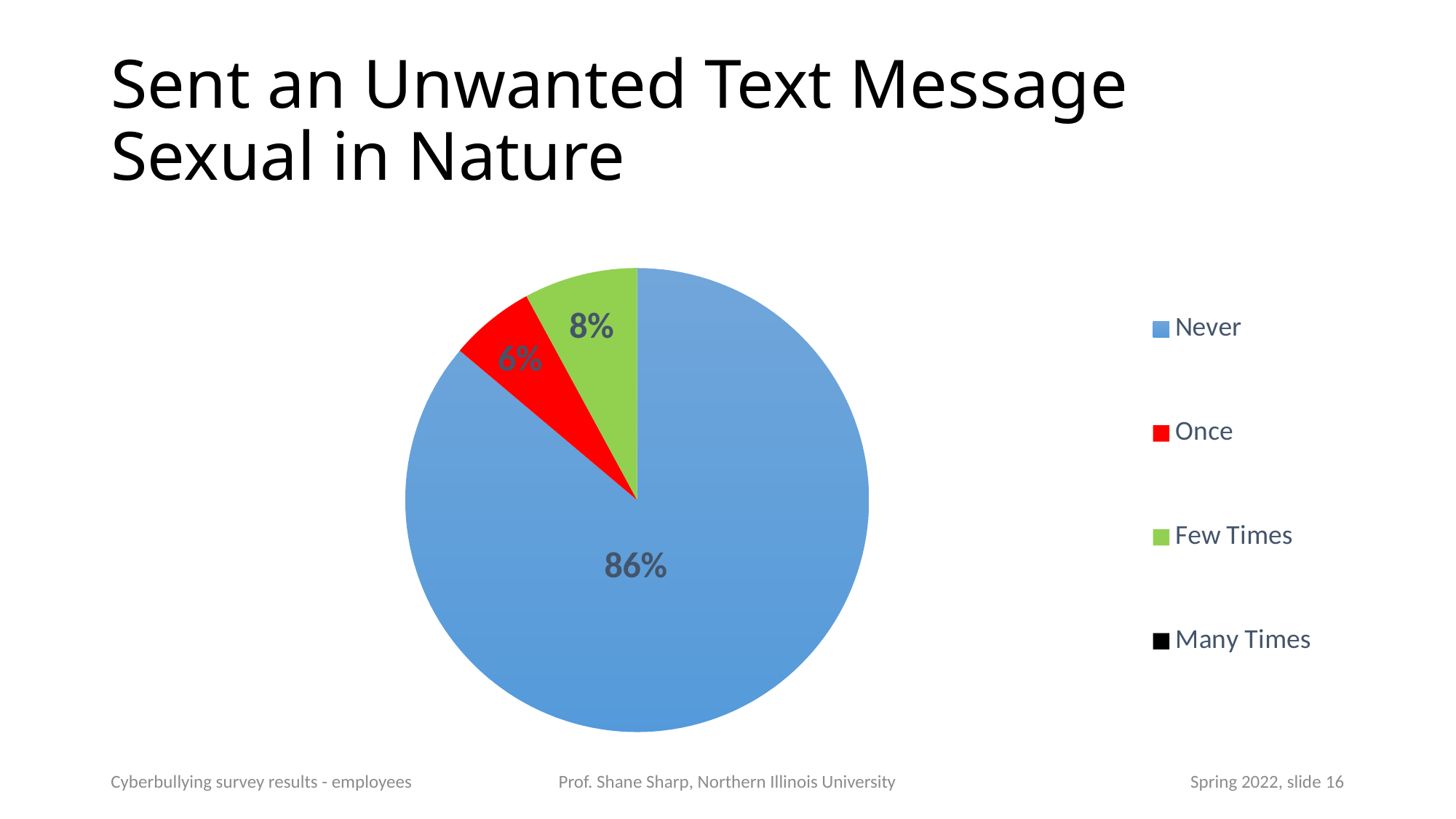
What share of the pie does the "Never" slice take up? 86% What is the title of the slide containing the chart? Sent an Unwanted Text Message Sexual in Nature What percentage of respondents answered "Once"? 6% Which category has the largest slice of the pie? Never What percentage of respondents answered "Few Times"? 8% What colour is the "Once" slice? red What percentage of respondents answered "Never"? 86% What kind of chart is shown on the slide? pie chart How many entries does the legend list? 4 Which is larger, the slice for "Once" or the slice for "Few Times"? Few Times What is the difference in percentage points between "Few Times" and "Once"? 2 What is the difference in percentage points between "Never" and "Few Times"? 78